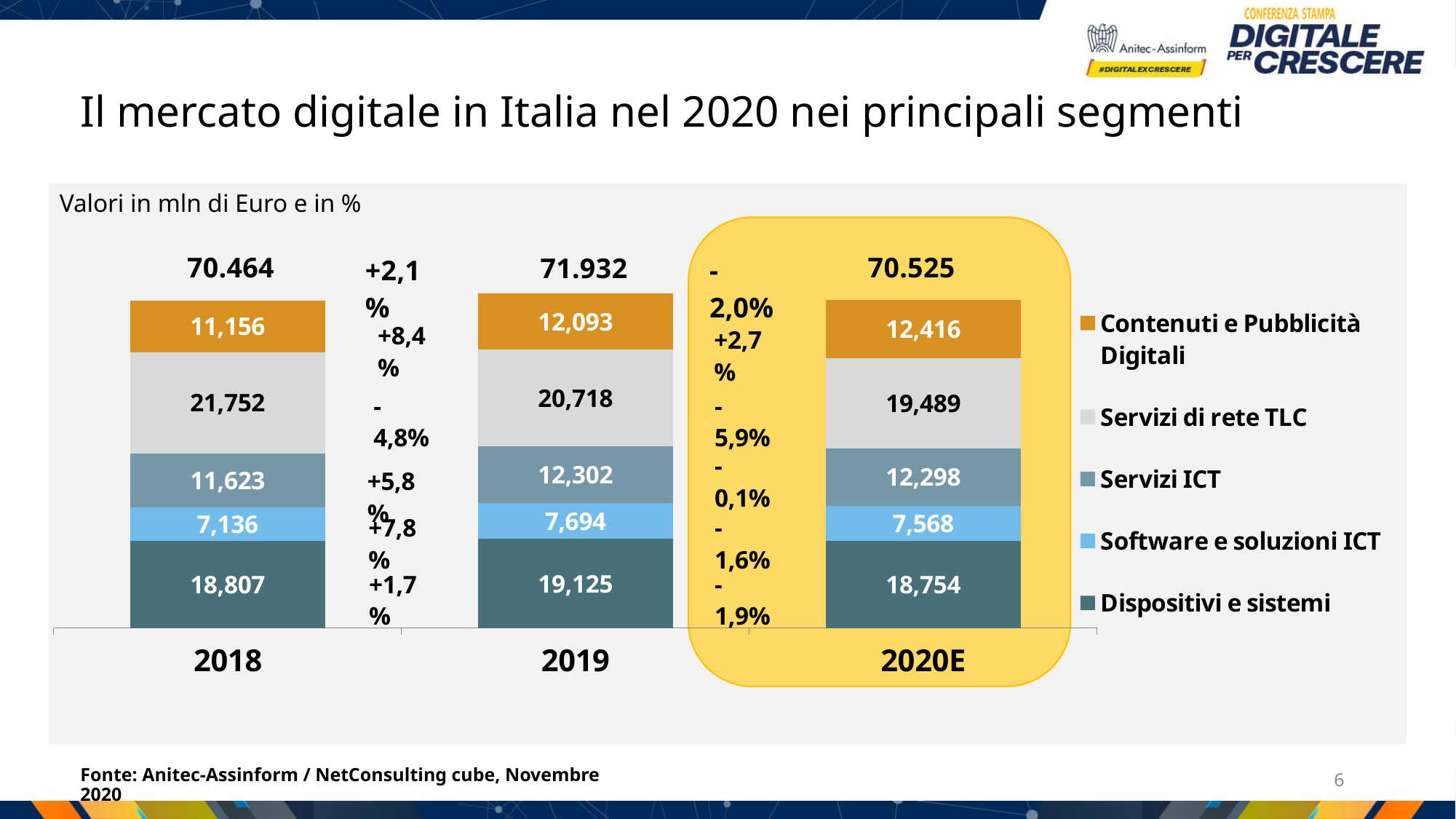
What kind of chart is shown? Stacked bar chart Which segment has the lowest value in 2018? Software e soluzioni ICT What is the value for Dispositivi e sistemi in 2020E? 18,754 What is the total of the stacked bar for 2019? 71.932 Which year has the highest total value? 2019 Which is larger in 2018: Dispositivi e sistemi or Servizi di rete TLC? Servizi di rete TLC What is the value for Servizi di rete TLC in 2018? 21,752 What is the value for Software e soluzioni ICT in 2019? 7,694 What is the difference between Contenuti e Pubblicità Digitali in 2019 and in 2018? 937 How many years are shown on the x axis? 3 How many series does the legend list? 5 Does the value for Servizi di rete TLC rise or fall from 2018 to 2020E? Fall